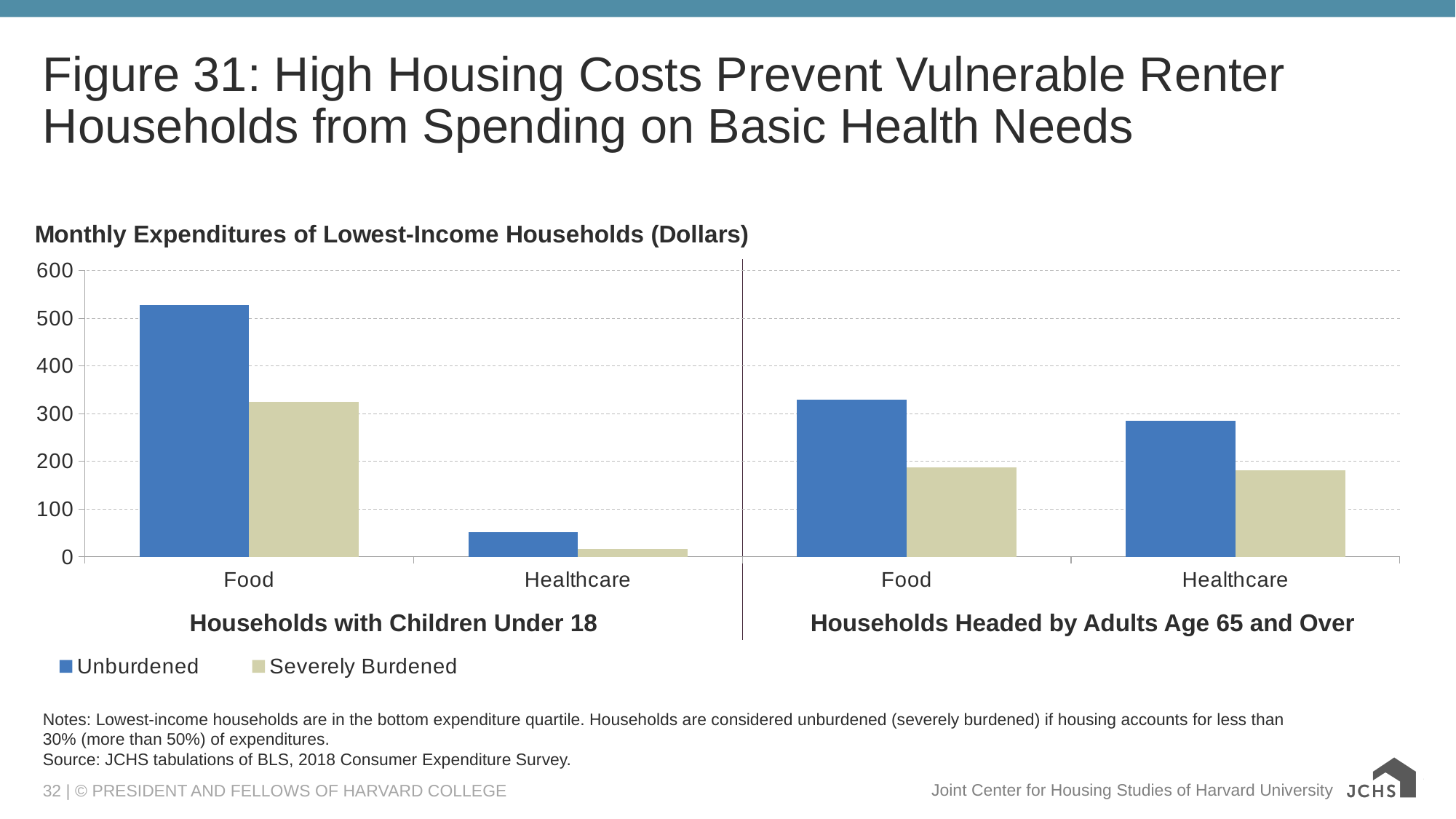
Which is larger: the Unburdened Healthcare value for Households with Children Under 18 or the Unburdened Healthcare value for Households Headed by Adults Age 65 and Over? Households Headed by Adults Age 65 and Over Which is larger: the Unburdened Food value for Households with Children Under 18 or the Unburdened Food value for Households Headed by Adults Age 65 and Over? Households with Children Under 18 Which bar is the highest in the chart? Unburdened, Food, Households with Children Under 18 Is the Unburdened value for Healthcare among Households with Children Under 18 greater or less than 100? less What are the two series named in the legend? Unburdened and Severely Burdened What is the title of the chart? Monthly Expenditures of Lowest-Income Households (Dollars) Is the Severely Burdened value for Food among Households with Children Under 18 greater or less than 300? greater How many series does the legend list? 2 What kind of chart is shown on the slide? bar chart Which bar is the lowest in the chart? Severely Burdened, Healthcare, Households with Children Under 18 Is the Severely Burdened value for Healthcare among Households Headed by Adults Age 65 and Over greater or less than 200? less